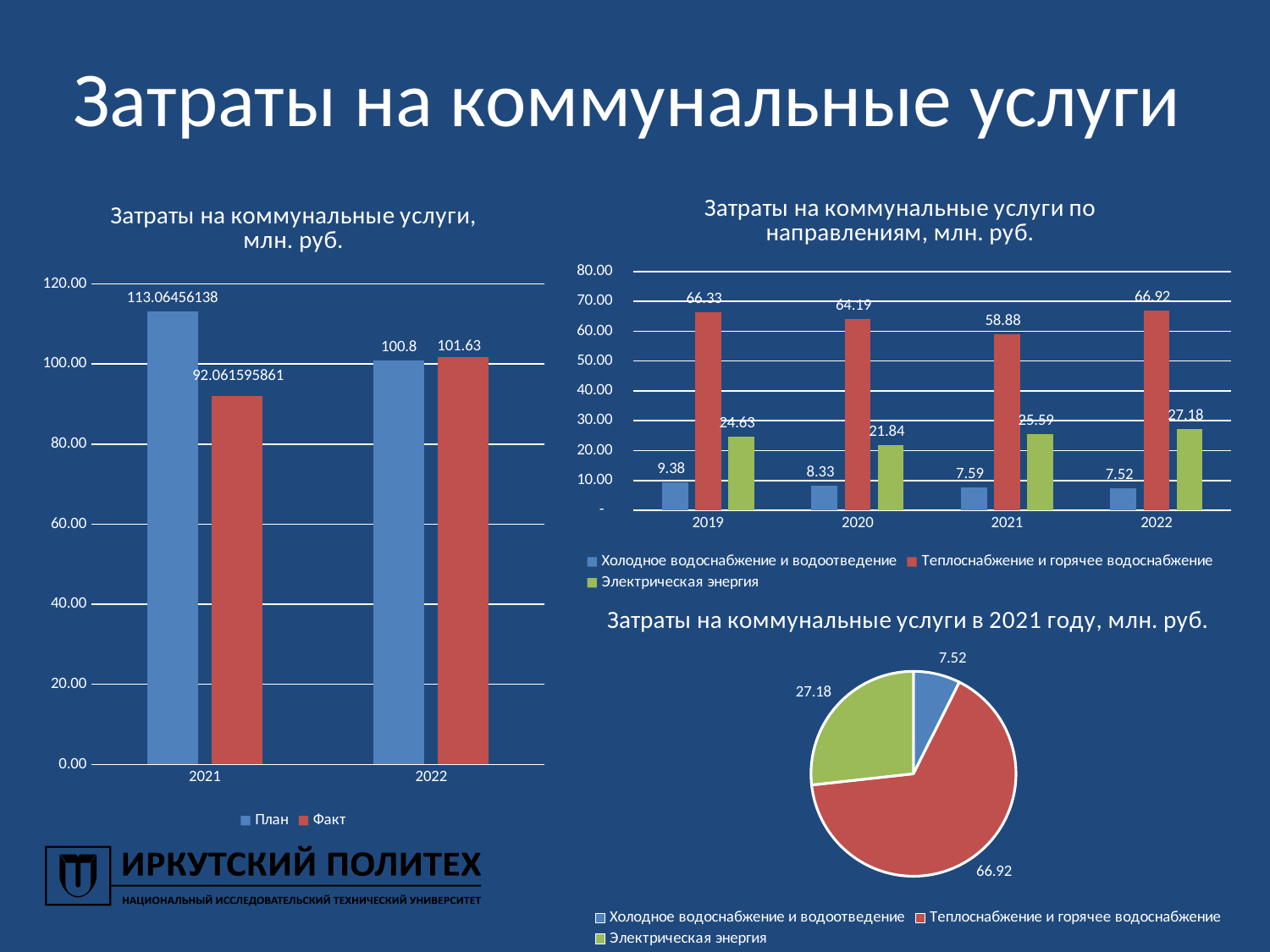
In the chart 'Затраты на коммунальные услуги по направлениям, млн. руб.', what is the value for Теплоснабжение и горячее водоснабжение in 2020? 64.19 How many series does the legend of the chart 'Затраты на коммунальные услуги, млн. руб.' list? 2 What kind of chart is 'Затраты на коммунальные услуги в 2021 году, млн. руб.'? pie chart In the chart 'Затраты на коммунальные услуги по направлениям, млн. руб.', what is the difference between Электрическая энергия in 2022 and in 2021? 1.59 In the chart 'Затраты на коммунальные услуги, млн. руб.', what is the Факт value for 2022? 101.63 In the chart 'Затраты на коммунальные услуги по направлениям, млн. руб.', does the value for Холодное водоснабжение и водоотведение rise or fall from 2019 to 2022? fall In the chart 'Затраты на коммунальные услуги, млн. руб.', which is larger for 2021: План or Факт? План In the chart 'Затраты на коммунальные услуги, млн. руб.', what is the План value for 2021? 113.06456138 How many years are shown on the x axis of the chart 'Затраты на коммунальные услуги по направлениям, млн. руб.'? 4 In the chart 'Затраты на коммунальные услуги, млн. руб.', what is the difference between План and Факт for 2022? 0.83 In the chart 'Затраты на коммунальные услуги по направлениям, млн. руб.', in which year is Теплоснабжение и горячее водоснабжение the lowest? 2021 In the pie chart 'Затраты на коммунальные услуги в 2021 году, млн. руб.', which category has the largest slice? Теплоснабжение и горячее водоснабжение